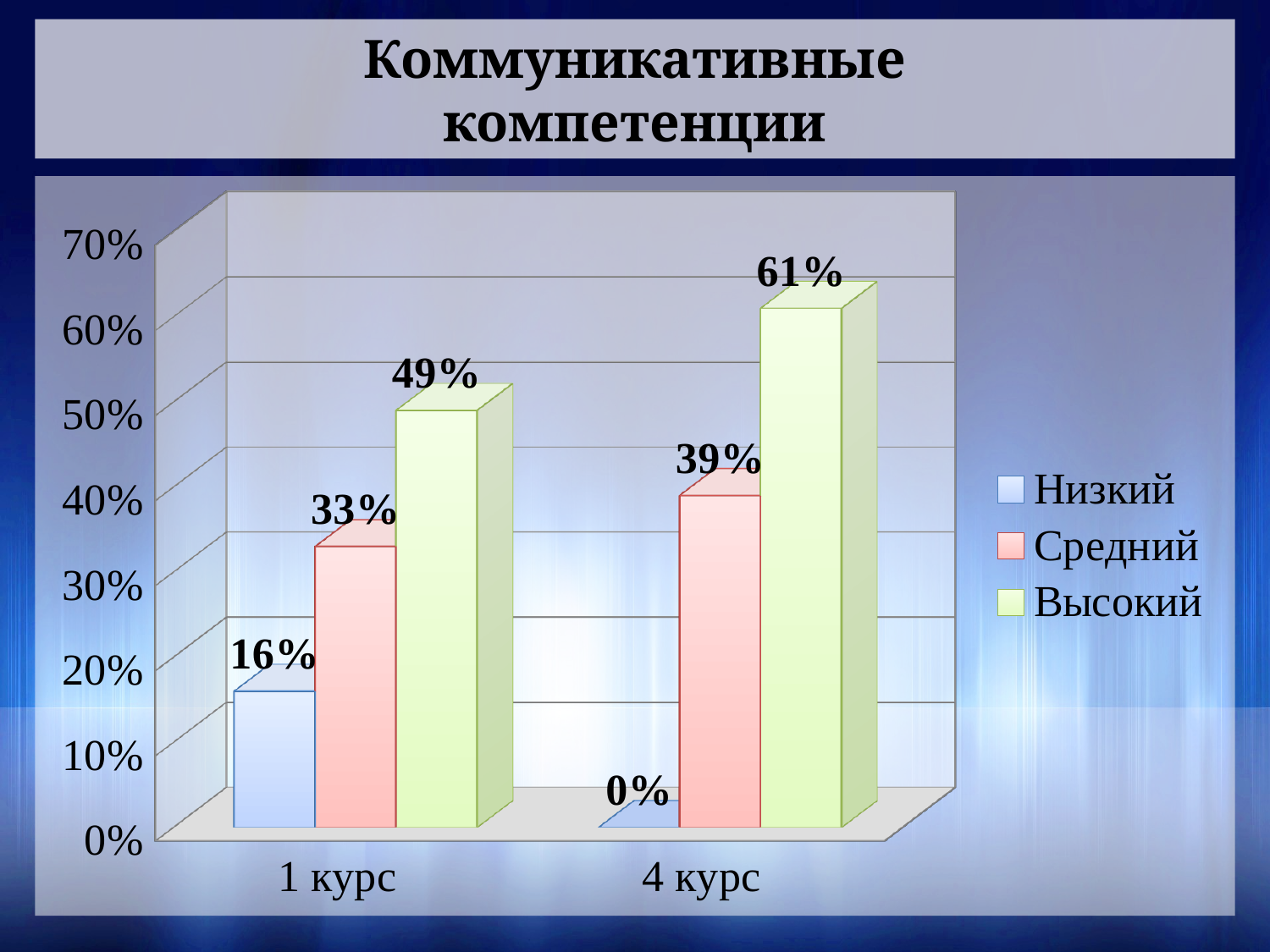
How many series does the legend list? 3 Which is larger: Средний in 1 курс or Средний in 4 курс? Средний in 4 курс What is the value for Низкий in 1 курс? 16% What is the difference between the Высокий values for 4 курс and 1 курс? 12% What is the value for Низкий in 4 курс? 0% What kind of chart is shown on the slide? Bar chart What is the value for Средний in 4 курс? 39% How many categories are shown on the x axis? 2 What is the value for Высокий in 4 курс? 61% What is the title of the slide? Коммуникативные компетенции Which series has the lowest value in 4 курс? Низкий Which series has the highest value in 1 курс? Высокий